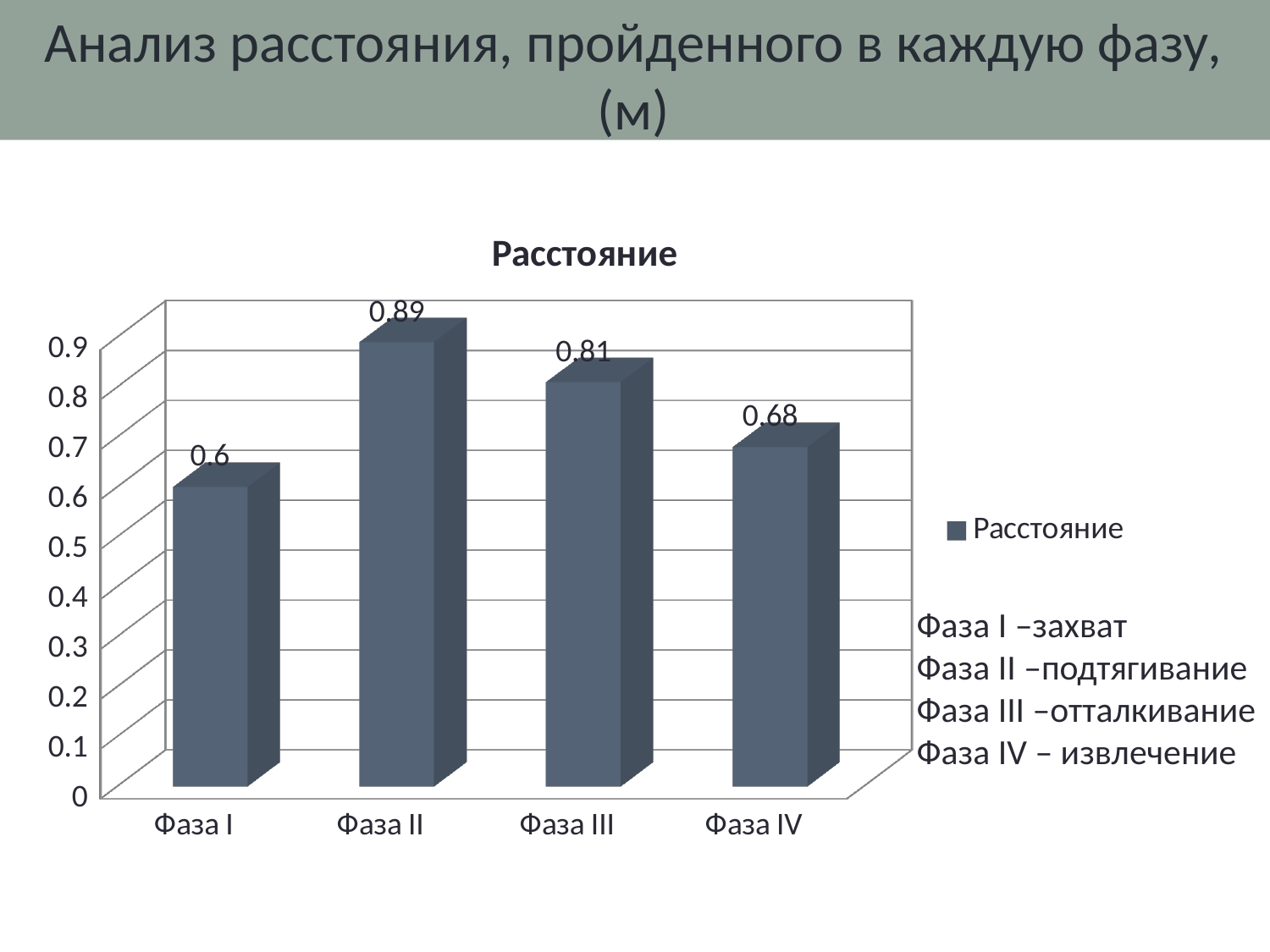
Which phase has the lowest value? Фаза I How many series does the legend list? 1 What is the title of the chart? Расстояние What is the value for Фаза I? 0.6 How many categories are shown on the x axis? 4 What is the value for Фаза III? 0.81 What is the value for Фаза II? 0.89 What is the difference between the values for Фаза II and Фаза I? 0.29 What kind of chart is shown? bar chart What is the value for Фаза IV? 0.68 Which phase has the highest value? Фаза II Which is larger, the value for Фаза III or the value for Фаза IV? Фаза III